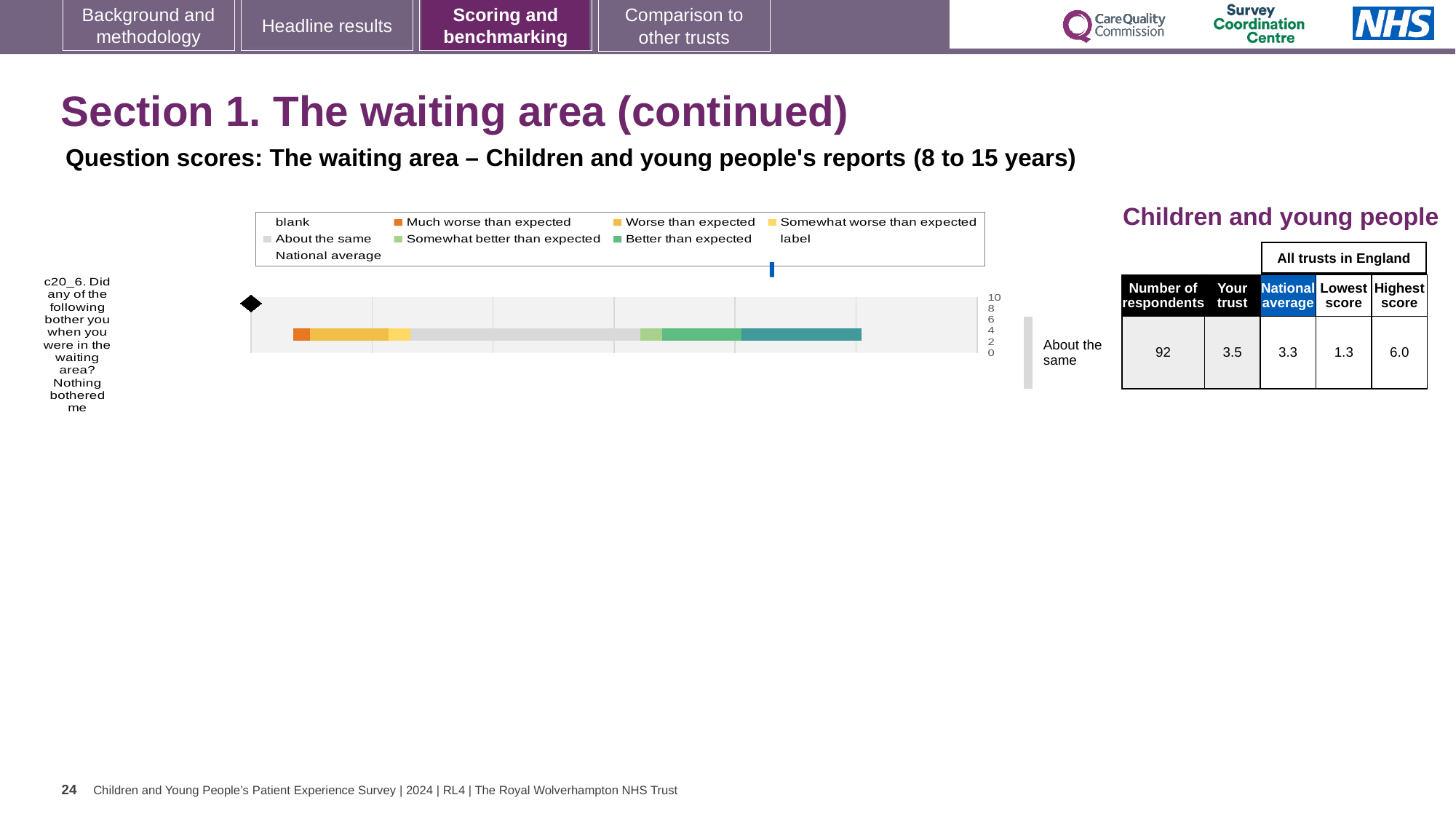
What is the national average score for question c20_6? 3.3 Which is larger for question c20_6: the trust's score or the national average? Your trust What is the difference between the highest score and the lowest score for question c20_6? 4.7 What is the maximum value shown on the chart's score axis? 10 What kind of chart is used to show the benchmarking for question c20_6? Bar chart What is the lowest score among all trusts in England for question c20_6? 1.3 How many respondents answered question c20_6? 92 What benchmark category is the trust's result for question c20_6 placed in? About the same What is the highest score among all trusts in England for question c20_6? 6.0 Is the trust's score for question c20_6 greater or less than 4? less What is the difference between the trust's score and the national average for question c20_6? 0.2 What is the 'Your trust' score for question c20_6 (Nothing bothered me in the waiting area)? 3.5